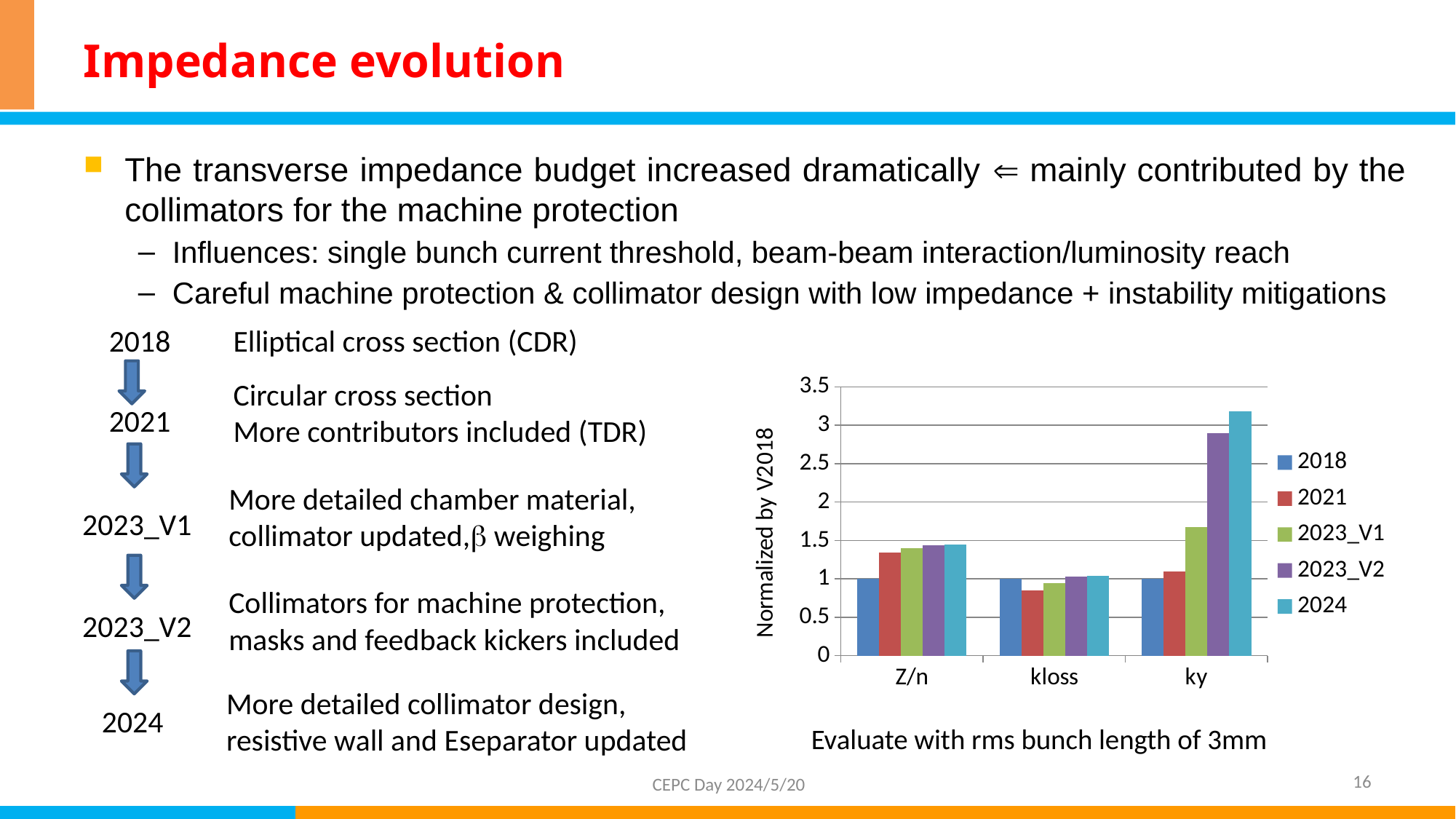
What is the title of the chart's y axis? Normalized by V2018 For ky, do the values rise or fall going from the 2018 series to the 2024 series? rise For ky, which is larger: the 2023_V1 value or the 2023_V2 value? 2023_V2 Is the value of the 2021 series for kloss greater or less than 1? less How many series does the chart legend list? 5 Is the value of the 2024 series for ky greater or less than 3? greater What is the value of the 2018 series for Z/n? 1 How many categories are shown on the x axis of the chart? 3 Which series has the lowest value for kloss? 2021 Is the value of the 2023_V2 series for ky greater or less than 2.5? greater What kind of chart is shown on the slide? bar chart Which series has the highest value for ky? 2024